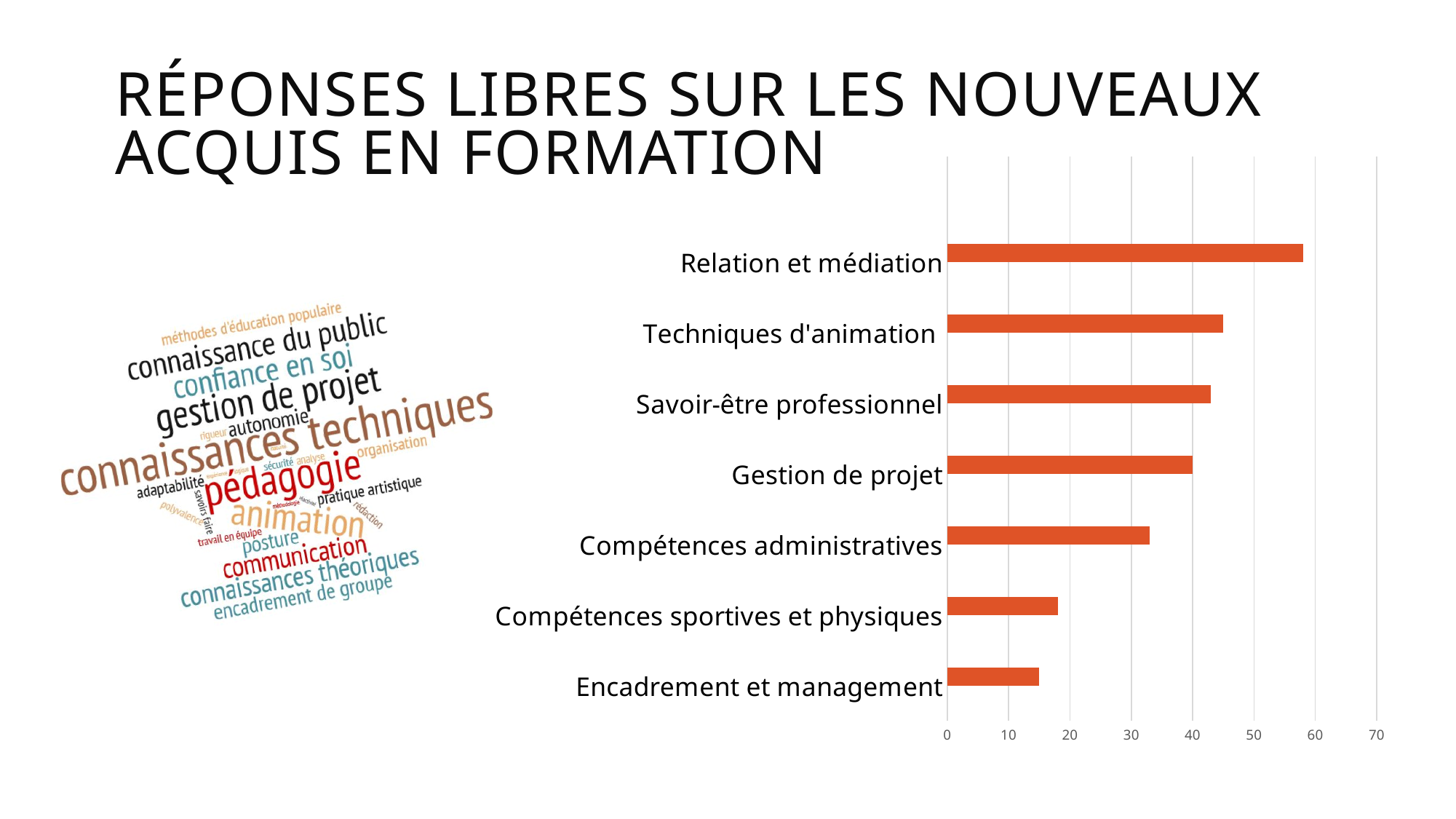
Is the value for Compétences sportives et physiques greater or less than 20? less Which category has the highest value in the bar chart? Relation et médiation What kind of chart is shown on the slide? bar chart Is the value for Encadrement et management greater or less than 20? less Is the value for Techniques d'animation greater or less than 40? greater Which is larger, the value for Relation et médiation or the value for Techniques d'animation? Relation et médiation What is the highest value shown on the horizontal axis of the bar chart? 70 How many categories are plotted in the bar chart? 7 Which is larger, the value for Compétences administratives or the value for Compétences sportives et physiques? Compétences administratives Which category has the lowest value in the bar chart? Encadrement et management